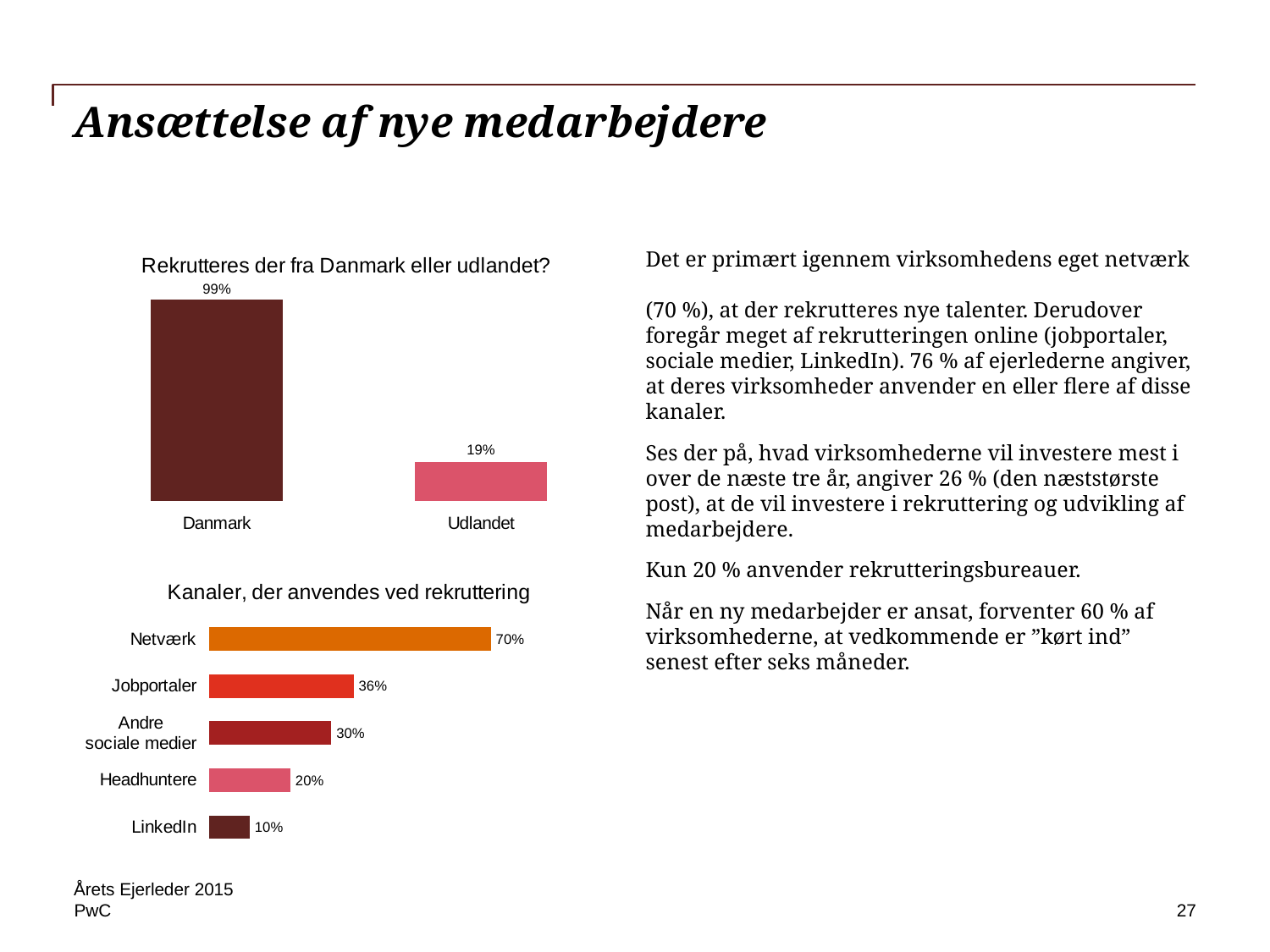
In the chart 'Kanaler, der anvendes ved rekruttering', how many categories are shown? 5 In the chart 'Kanaler, der anvendes ved rekruttering', what is the value for Andre sociale medier? 30% What kind of chart is 'Kanaler, der anvendes ved rekruttering'? Bar chart In the chart 'Rekrutteres der fra Danmark eller udlandet?', what is the difference between the values for Danmark and Udlandet? 80% In the chart 'Kanaler, der anvendes ved rekruttering', which category has the highest value? Netværk In the chart 'Rekrutteres der fra Danmark eller udlandet?', what is the value for Udlandet? 19% In the chart 'Rekrutteres der fra Danmark eller udlandet?', what is the value for Danmark? 99% In the chart 'Kanaler, der anvendes ved rekruttering', which is larger: Jobportaler or Andre sociale medier? Jobportaler In the chart 'Kanaler, der anvendes ved rekruttering', which category has the lowest value? LinkedIn In the chart 'Kanaler, der anvendes ved rekruttering', what is the value for Jobportaler? 36% In the chart 'Kanaler, der anvendes ved rekruttering', what is the difference between the values for Netværk and Headhuntere? 50% In the chart 'Rekrutteres der fra Danmark eller udlandet?', how many categories are shown? 2